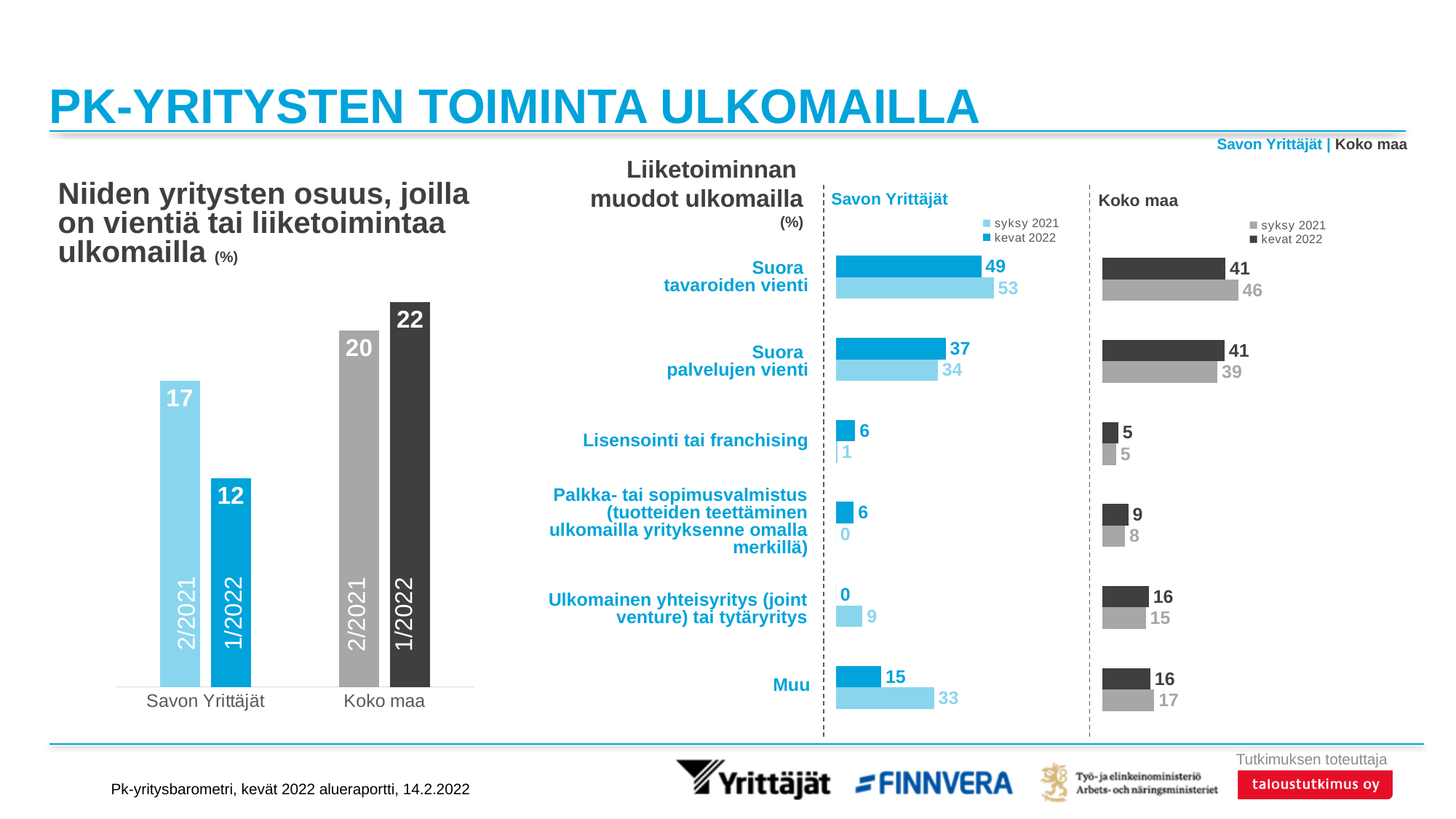
What kind of chart is the left chart 'Niiden yritysten osuus, joilla on vientiä tai liiketoimintaa ulkomailla'? bar chart In the left chart 'Niiden yritysten osuus, joilla on vientiä tai liiketoimintaa ulkomailla', which bar is the highest? Koko maa 1/2022 In the right chart 'Liiketoiminnan muodot ulkomailla', how many categories of business forms are listed? 6 In the right chart 'Liiketoiminnan muodot ulkomailla', which is larger for Savon Yrittäjät in kevät 2022: 'Suora tavaroiden vienti' or 'Suora palvelujen vienti'? Suora tavaroiden vienti In the left chart 'Niiden yritysten osuus, joilla on vientiä tai liiketoimintaa ulkomailla', did the value for Savon Yrittäjät rise or fall from 2/2021 to 1/2022? fall In the left chart 'Niiden yritysten osuus, joilla on vientiä tai liiketoimintaa ulkomailla', what is the value for Savon Yrittäjät in 1/2022? 12 In the right chart 'Liiketoiminnan muodot ulkomailla', what is the Savon Yrittäjät value for 'Suora tavaroiden vienti' in kevät 2022? 49 In the right chart 'Liiketoiminnan muodot ulkomailla', what is the Koko maa value for 'Suora palvelujen vienti' in syksy 2021? 39 In the right chart 'Liiketoiminnan muodot ulkomailla', what is the Savon Yrittäjät value for 'Muu' in syksy 2021? 33 In the right chart 'Liiketoiminnan muodot ulkomailla', how many series does the Savon Yrittäjät legend list? 2 In the left chart 'Niiden yritysten osuus, joilla on vientiä tai liiketoimintaa ulkomailla', what is the difference between Savon Yrittäjät 2/2021 and 1/2022? 5 In the left chart 'Niiden yritysten osuus, joilla on vientiä tai liiketoimintaa ulkomailla', what is the value for Koko maa in 2/2021? 20